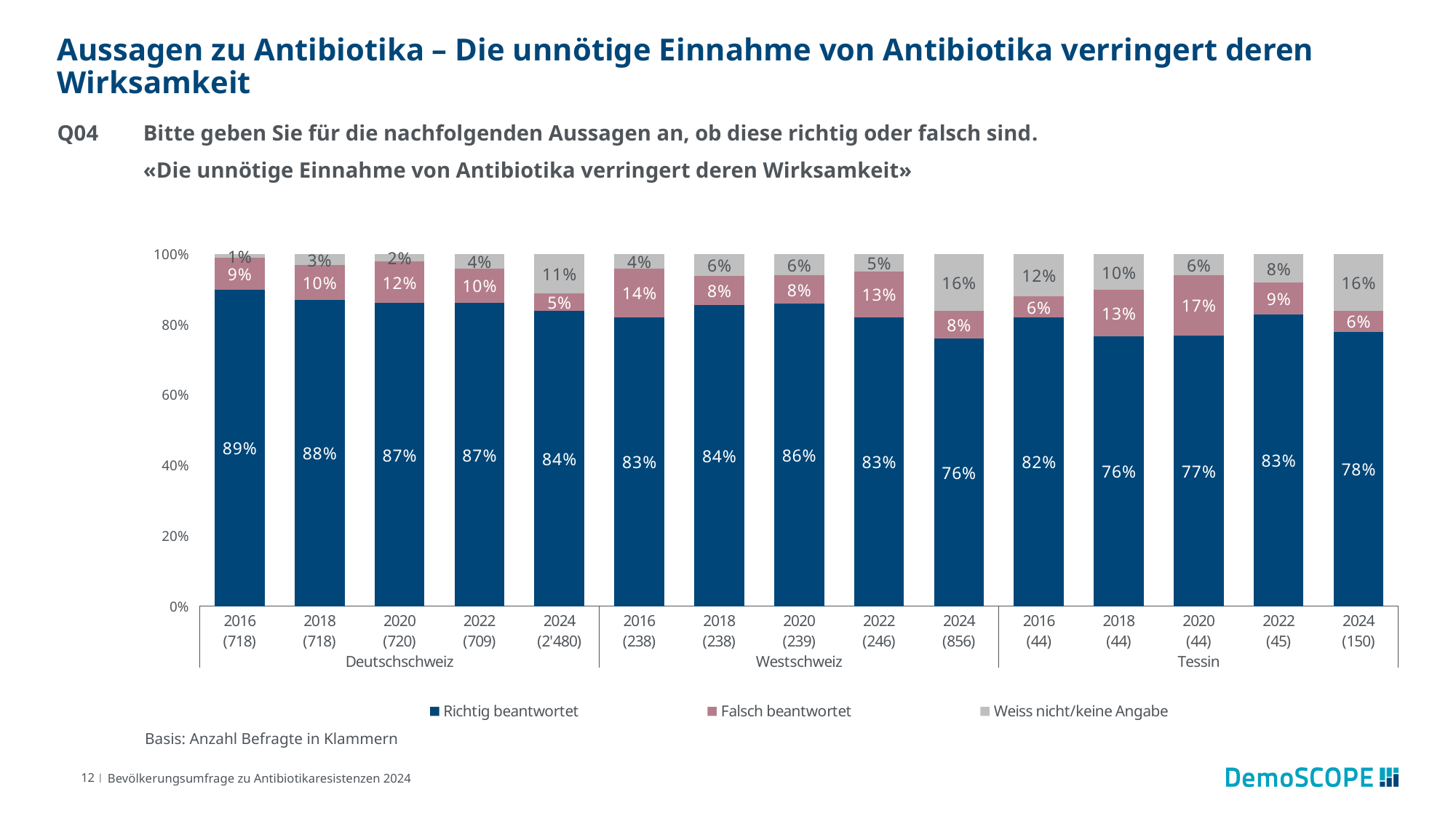
What is the share of 'Weiss nicht/keine Angabe' for Tessin in 2024? 16% What is the 'Falsch beantwortet' value for Tessin in 2020? 17% By how many percentage points did 'Richtig beantwortet' in Deutschschweiz fall from 2016 to 2024? 5 percentage points How many respondents (in parentheses) are given for Deutschschweiz in 2024? 2'480 Within Deutschschweiz, which year has the lowest 'Richtig beantwortet' share? 2024 (84%) What kind of chart is shown on the slide? Stacked bar chart How many series does the legend list? 3 Which region and year has the highest 'Richtig beantwortet' share? Deutschschweiz 2016 (89%) What percentage of respondents in Deutschschweiz answered correctly (Richtig beantwortet) in 2016? 89% Does the 'Richtig beantwortet' share in Deutschschweiz rise or fall from 2016 to 2024? Fall How many bars are shown in the chart? 15 Which is larger: 'Falsch beantwortet' for Westschweiz 2016 or for Tessin 2020? Tessin 2020 (17%)